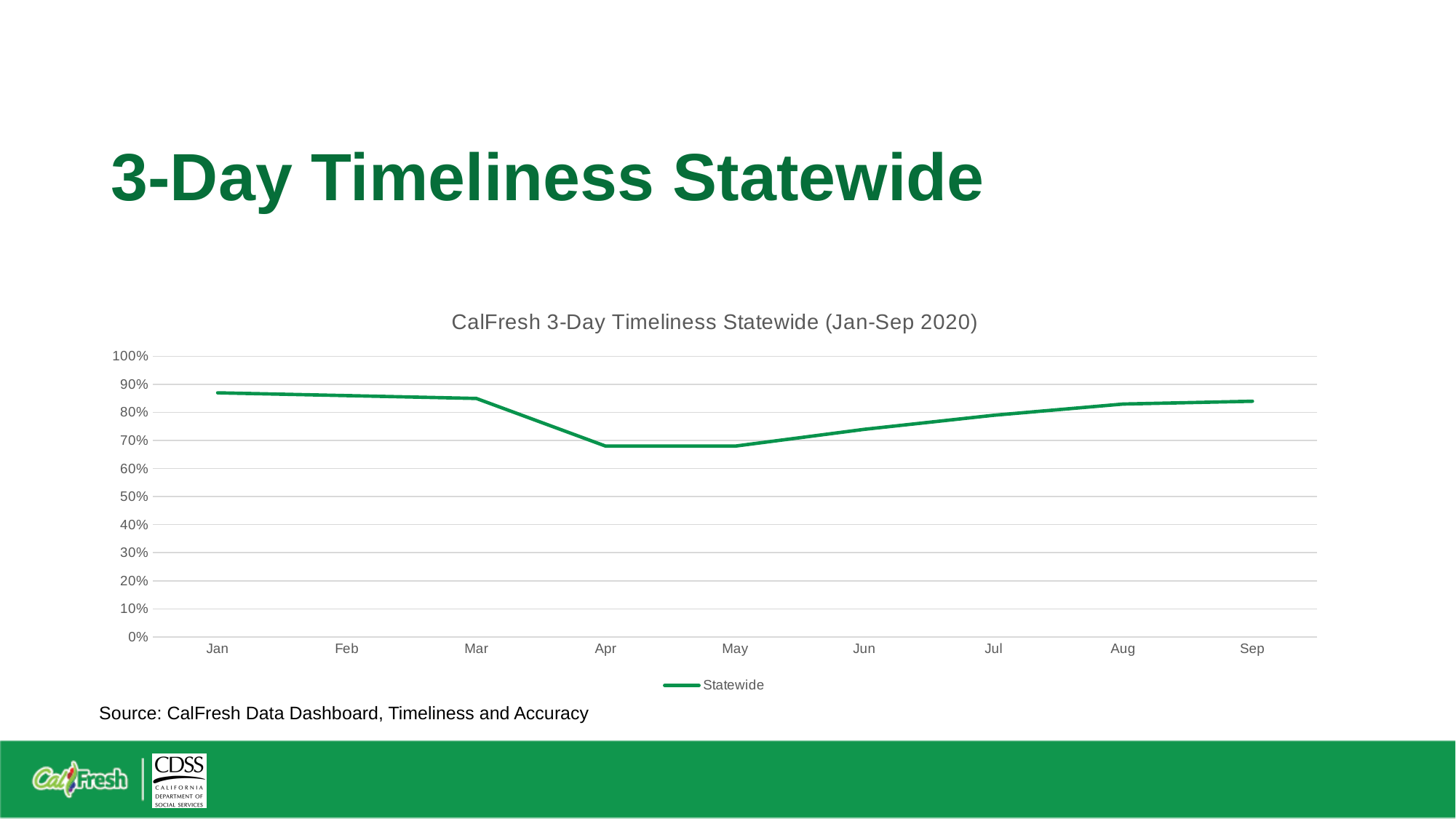
How many series does the legend list? 1 Do the values rise or fall from Apr to Sep? Rise What is the title of the chart? CalFresh 3-Day Timeliness Statewide (Jan-Sep 2020) Is the value for Jun greater or less than 70%? greater Is the value for Sep greater or less than 80%? greater Is the value for Jan greater or less than 80%? greater How many months are plotted along the x axis? 9 Which month has the larger value, Jan or Sep? Jan What kind of chart is shown on the slide? Line chart What is the name of the series shown in the legend? Statewide Which month has the larger value, Mar or Apr? Mar